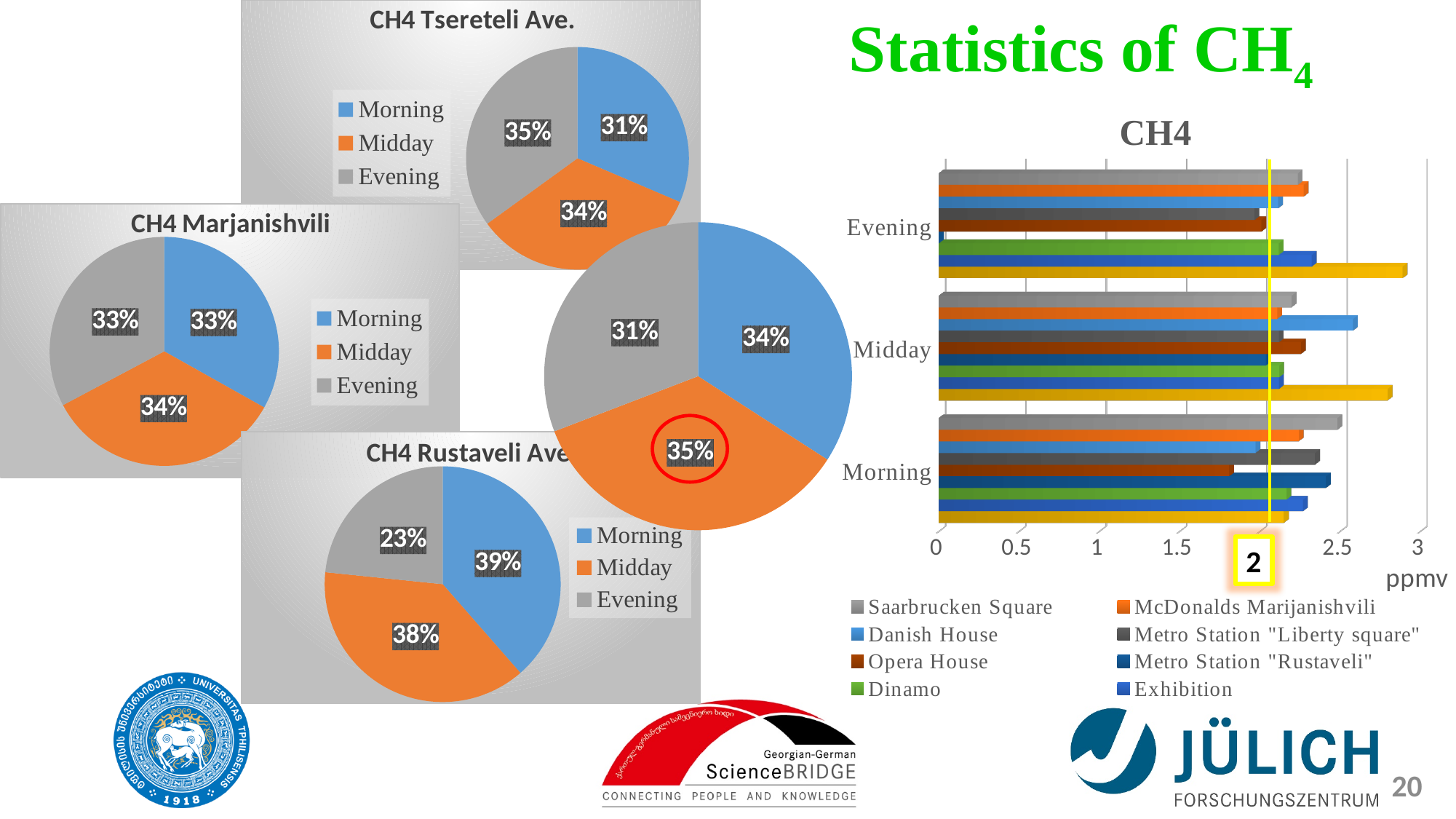
In the large untitled pie chart in the centre of the slide, what share does Evening have? 31% In the CH4 Rustaveli Ave pie chart, which time of day has the smallest share? Evening How many categories are shown on the vertical axis of the CH4 bar chart on the right? 3 In the large untitled pie chart in the centre of the slide, what share is circled in red? 35% In the CH4 Tsereteli Ave. pie chart, what share does Morning have? 31% In the CH4 Marjanishvili pie chart, what share does Midday have? 34% In the CH4 Rustaveli Ave pie chart, which is larger, Morning or Midday? Morning How many series does the legend of the CH4 bar chart on the right list? 8 In the CH4 Rustaveli Ave pie chart, what is the difference between the Morning and Evening shares? 16% What kind of chart is the CH4 chart on the right side of the slide? Bar chart In the CH4 Tsereteli Ave. pie chart, which time of day has the largest share? Evening